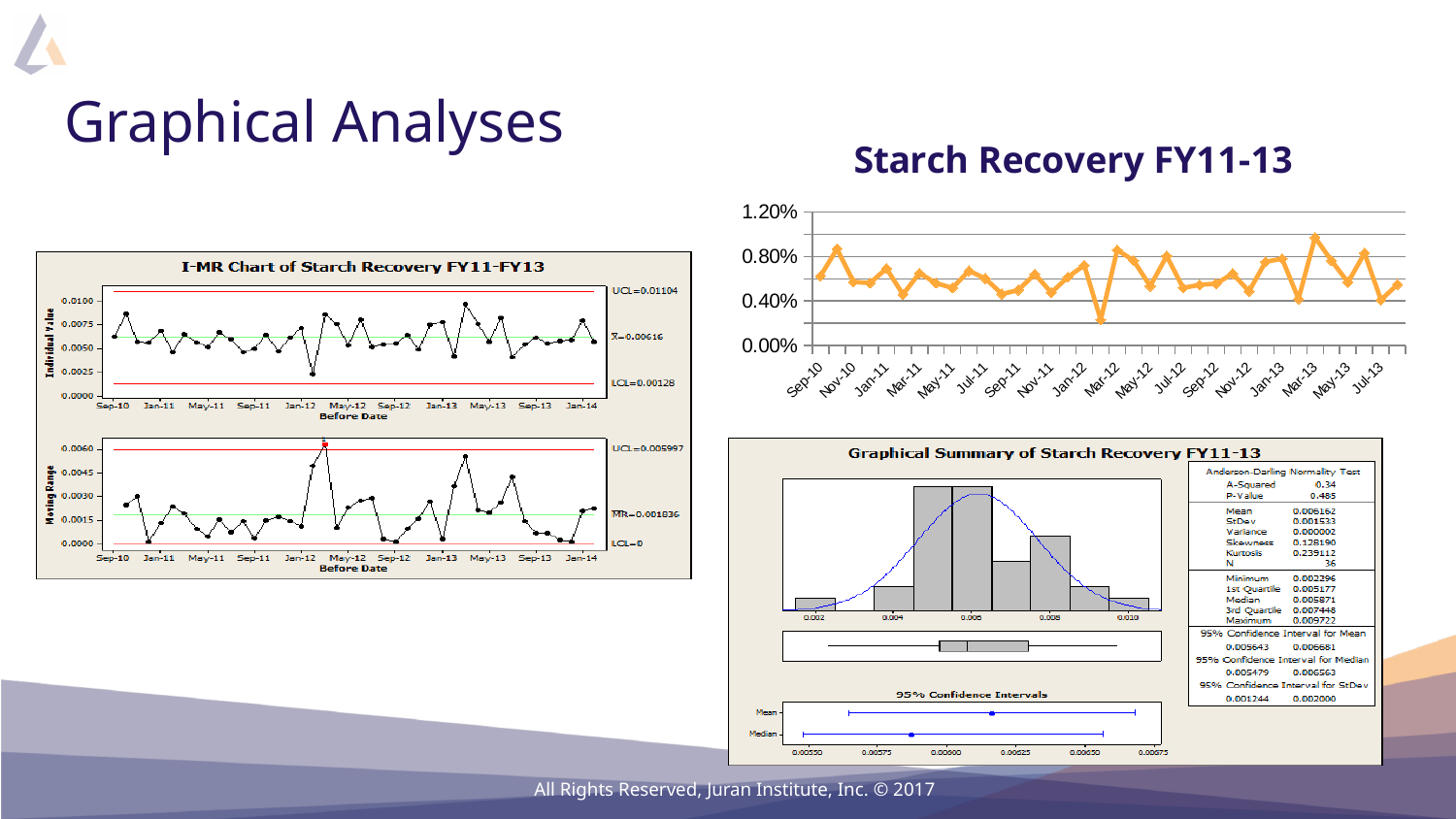
What kind of chart is the 'Starch Recovery FY11-13' chart at the top right? line chart On the 'Graphical Summary of Starch Recovery FY11-13', what is the Mean? 0.006162 On the 'I-MR Chart of Starch Recovery FY11-FY13', what is the mean (X-bar) value shown on the Individual Value chart? 0.00616 On the 'I-MR Chart of Starch Recovery FY11-FY13', what is the MR-bar value shown on the Moving Range chart? 0.001836 On the 'I-MR Chart of Starch Recovery FY11-FY13', what is the LCL shown on the Individual Value chart? 0.00128 On the 'Graphical Summary of Starch Recovery FY11-13', what is the Maximum? 0.009722 On the 'Starch Recovery FY11-13' chart, is the value for Mar-12 greater or less than 0.40%? greater On the 'Starch Recovery FY11-13' chart, what is the highest value shown on the y axis? 1.20% On the 'Starch Recovery FY11-13' chart, is the value for Mar-13 greater or less than 0.80%? greater On the 'I-MR Chart of Starch Recovery FY11-FY13', what is the UCL shown on the Individual Value chart? 0.01104 On the 'Graphical Summary of Starch Recovery FY11-13', what is N? 36 On the 'I-MR Chart of Starch Recovery FY11-FY13', what is the UCL shown on the Moving Range chart? 0.005997